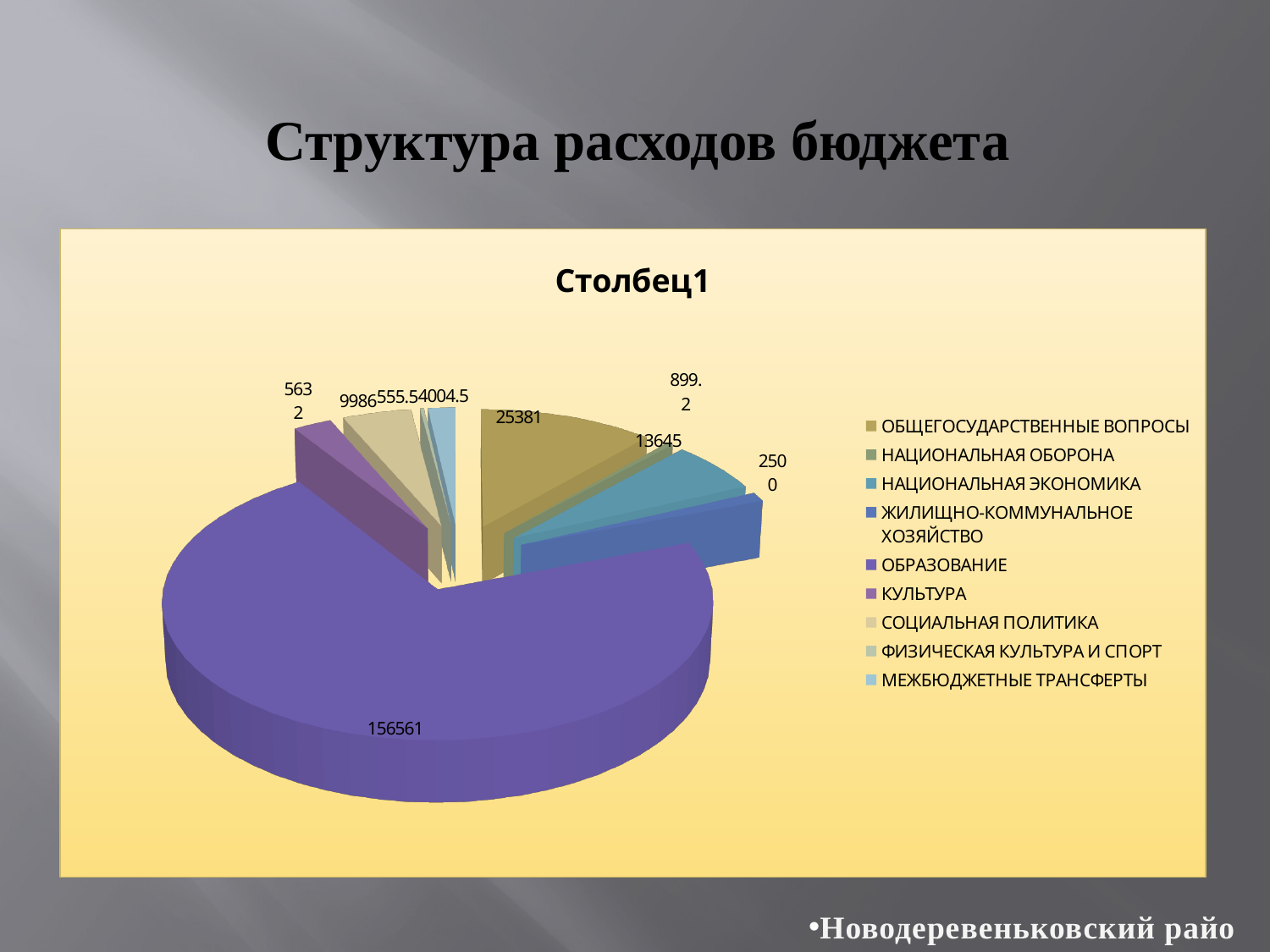
What is the difference between the values for ОБЩЕГОСУДАРСТВЕННЫЕ ВОПРОСЫ and НАЦИОНАЛЬНАЯ ЭКОНОМИКА? 11736 What is the title of the chart? Столбец1 Which is larger, the value for НАЦИОНАЛЬНАЯ ЭКОНОМИКА or the value for СОЦИАЛЬНАЯ ПОЛИТИКА? НАЦИОНАЛЬНАЯ ЭКОНОМИКА What is the value shown for СОЦИАЛЬНАЯ ПОЛИТИКА? 9986 Which category has the largest slice of the pie? ОБРАЗОВАНИЕ What is the value shown for ОБРАЗОВАНИЕ? 156561 What type of chart is shown on the slide? Pie chart Which colour is used for the ОБРАЗОВАНИЕ slice? Purple How many categories does the legend of the pie chart list? 9 What is the value shown for КУЛЬТУРА? 5632 What is the value shown for ОБЩЕГОСУДАРСТВЕННЫЕ ВОПРОСЫ? 25381 What is the value shown for НАЦИОНАЛЬНАЯ ЭКОНОМИКА? 13645